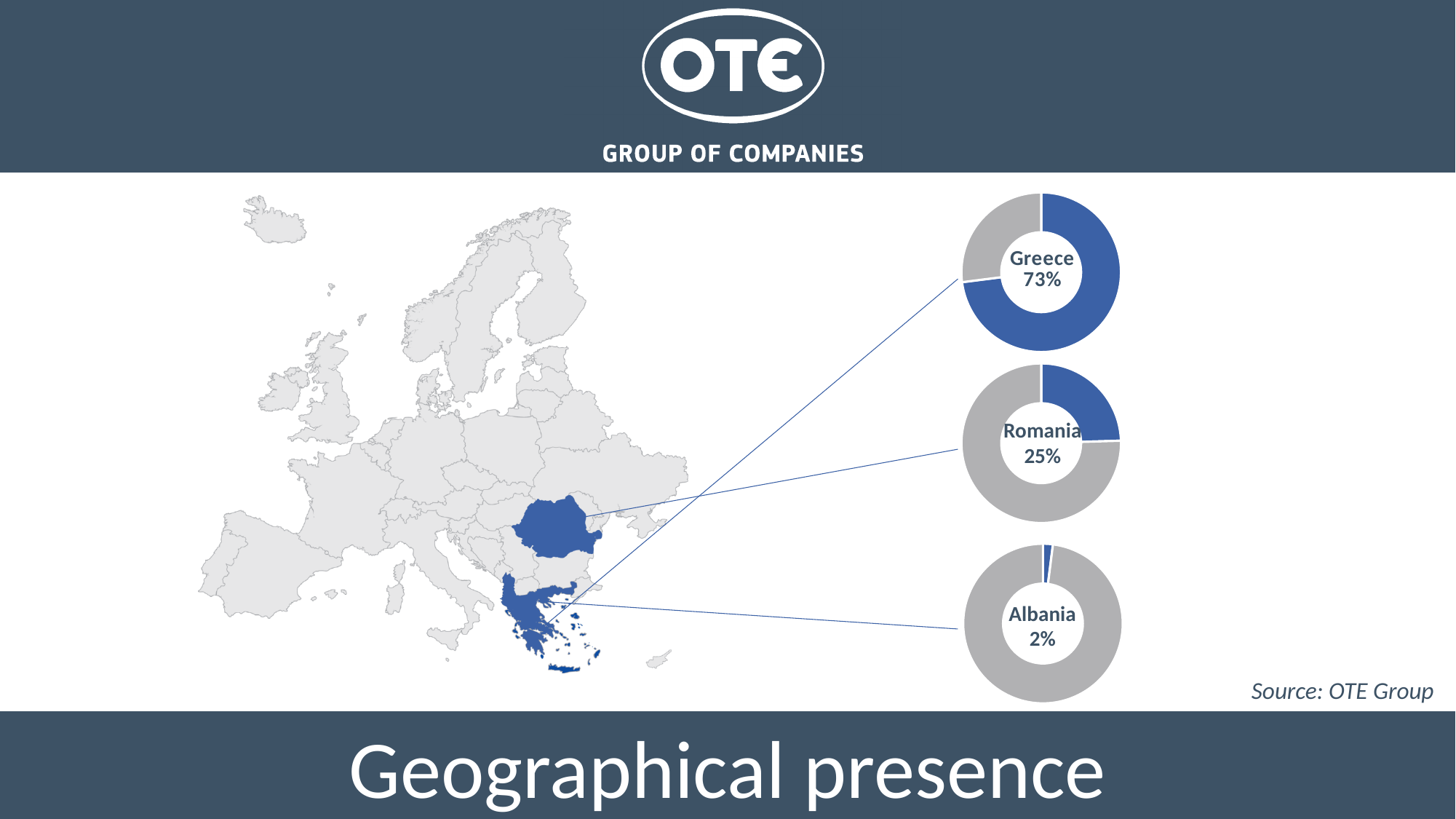
Across the three donut charts, which country has the highest percentage? Greece In the middle donut chart, what percentage is shown for Romania? 25% In the top donut chart, what percentage is shown for Greece? 73% How many donut charts are shown on the slide? 3 Which is larger: the Romania percentage in the middle donut chart or the Albania percentage in the bottom donut chart? Romania What kind of charts are shown on the right side of the slide? Donut (pie) charts What colour is used for the highlighted slice in each donut chart? Blue In the bottom donut chart, what percentage is shown for Albania? 2% What is the difference between the Greece percentage in the top donut chart and the Romania percentage in the middle donut chart? 48% What is the difference between the Romania percentage in the middle donut chart and the Albania percentage in the bottom donut chart? 23% In the top donut chart, is the value for Greece greater or less than 50%? greater Across the three donut charts, which country has the lowest percentage? Albania